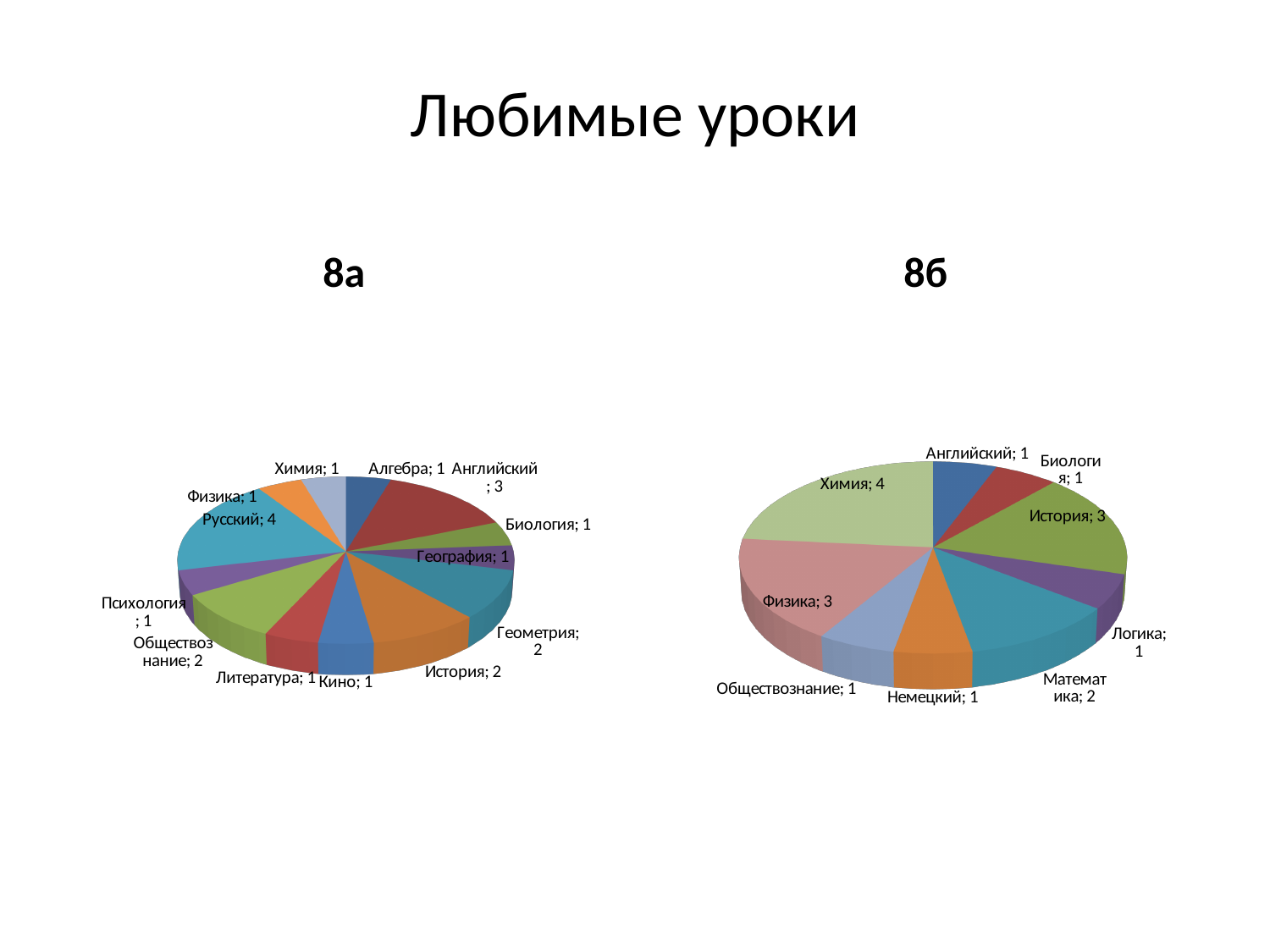
In the 8б chart, which is larger, the value for История or the value for Логика? История How many slices does the 8б chart have? 9 What is the title of the slide containing the two charts? Любимые уроки What kind of chart is the 8б chart? Pie chart In the 8б chart, which subject has the largest slice? Химия In the 8а chart, which subject has the largest slice? Русский In the 8б chart, what is the value for Физика? 3 In the 8б chart, what is the difference between the values for Химия and Математика? 2 How many slices does the 8а chart have? 13 In the 8а chart, what is the difference between the values for Русский and Английский? 1 In the 8а chart, what is the value for Русский? 4 In the 8а chart, which is larger, the value for Геометрия or the value for Кино? Геометрия